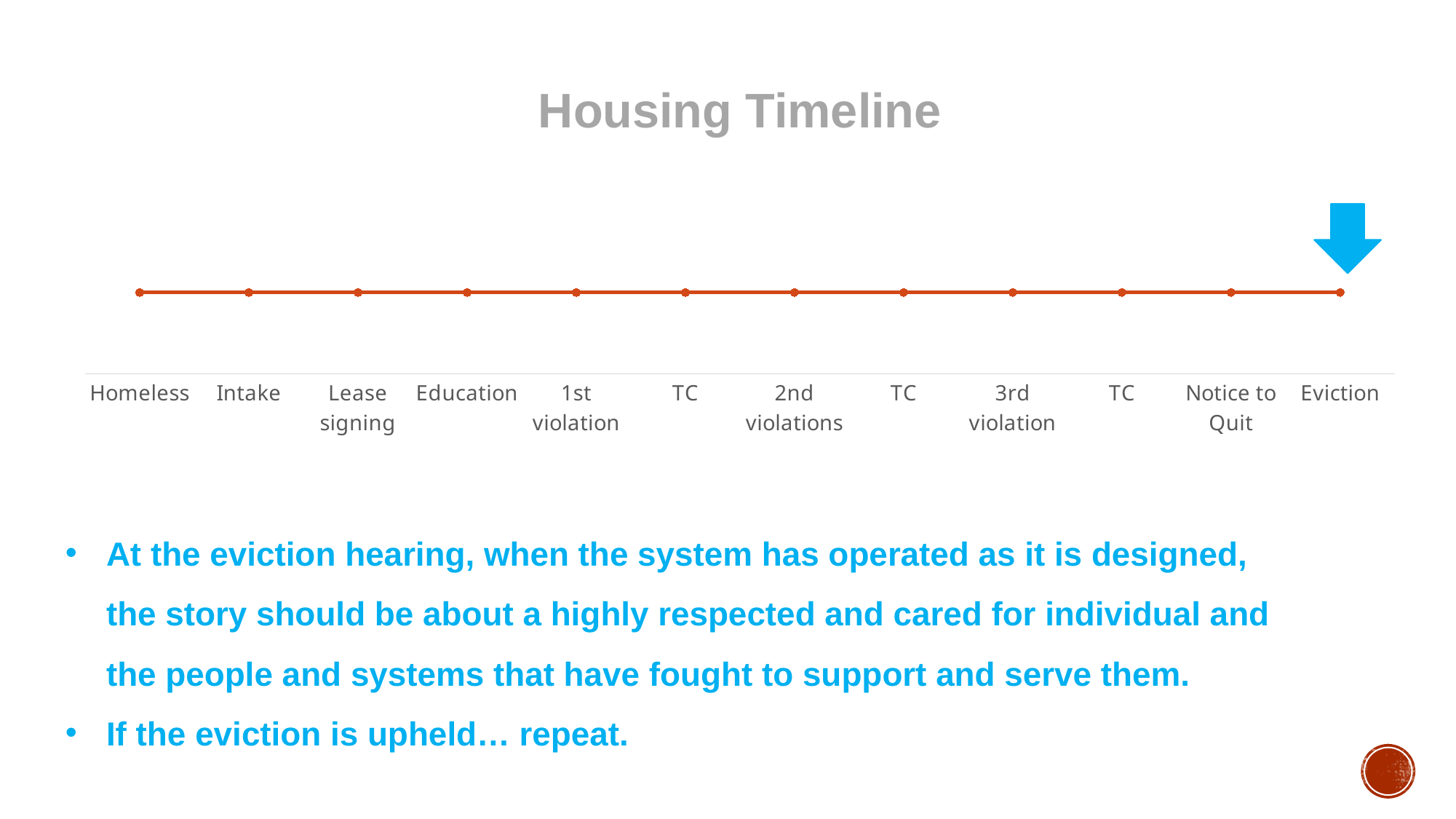
Do the plotted values rise, fall, or stay flat from Homeless to Eviction? stay flat Which category comes immediately after Lease signing on the timeline? Education Which category does the blue arrow point to on the timeline? Eviction What is the last category on the right of the timeline? Eviction What is the title of the chart? Housing Timeline What is the first category on the left of the timeline? Homeless What kind of chart is used for the Housing Timeline? line chart